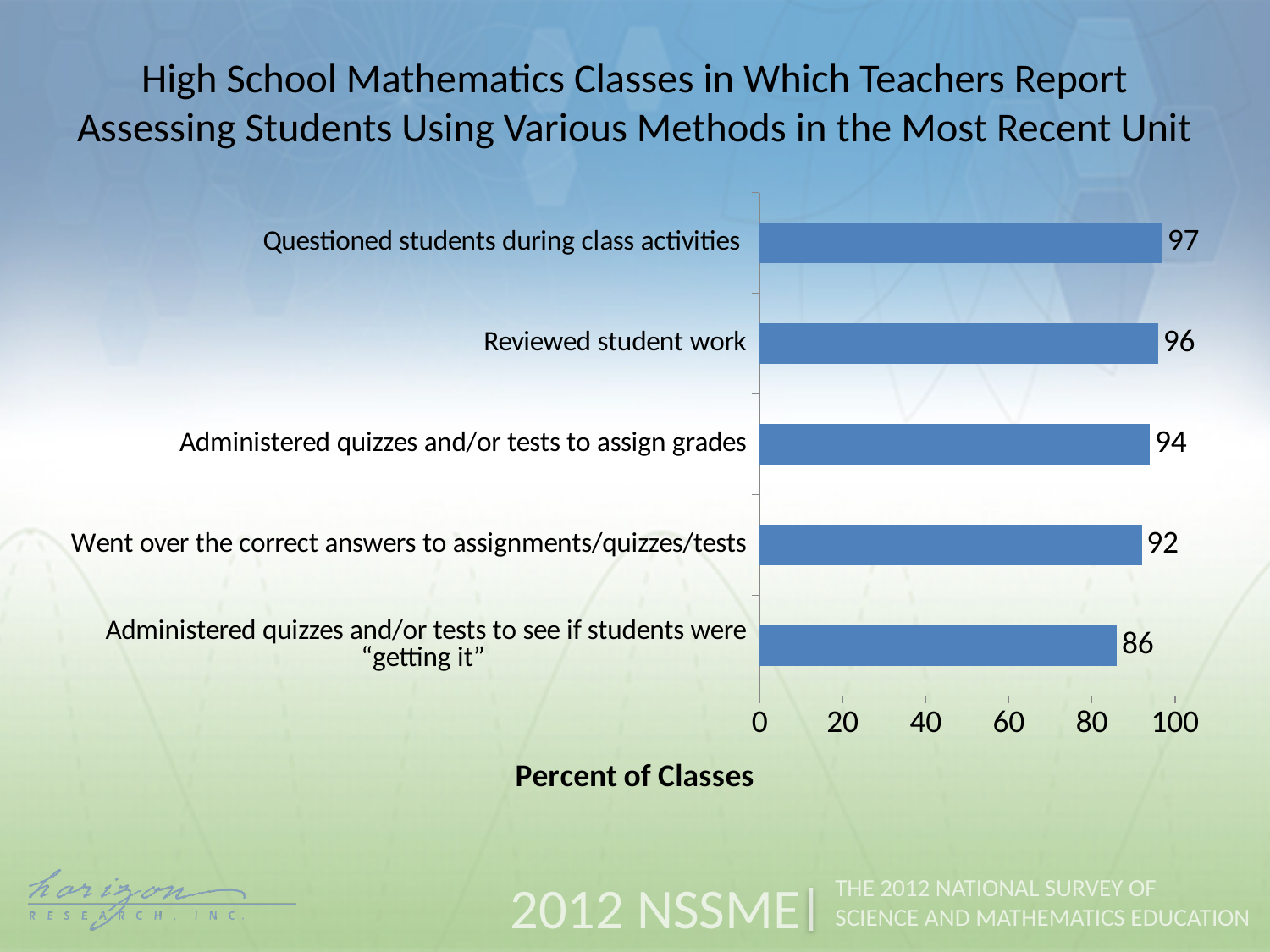
What percent of classes reported 'Questioned students during class activities'? 97 What is the difference between 'Reviewed student work' and 'Administered quizzes and/or tests to see if students were "getting it"'? 10 Which assessment method has the lowest percent of classes? Administered quizzes and/or tests to see if students were "getting it" How many assessment methods are shown in the chart? 5 What is the value for 'Went over the correct answers to assignments/quizzes/tests'? 92 What is the value for 'Administered quizzes and/or tests to see if students were "getting it"'? 86 What is the difference between 'Questioned students during class activities' and 'Went over the correct answers to assignments/quizzes/tests'? 5 Which is larger: 'Administered quizzes and/or tests to assign grades' or 'Went over the correct answers to assignments/quizzes/tests'? Administered quizzes and/or tests to assign grades Which assessment method has the highest percent of classes? Questioned students during class activities What is the label of the horizontal axis? Percent of Classes What kind of chart is shown on the slide? Bar chart Is the value for 'Administered quizzes and/or tests to see if students were "getting it"' greater or less than 80? greater